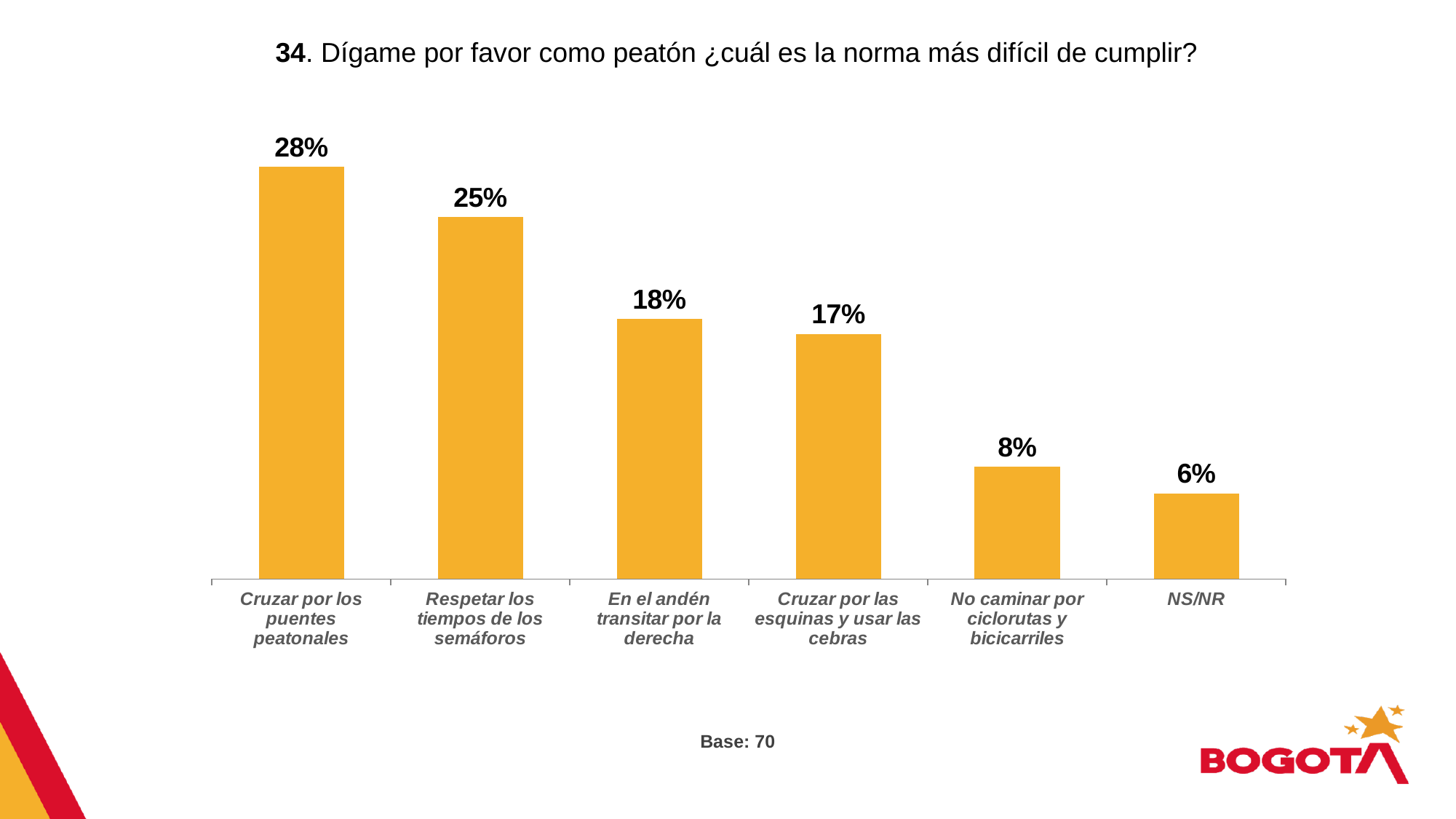
How many categories are shown in the chart? 6 What is the value for "Respetar los tiempos de los semáforos"? 25% Which category has the highest value? Cruzar por los puentes peatonales What is the difference between "Cruzar por las esquinas y usar las cebras" and "No caminar por ciclorutas y bicicarriles"? 9% What kind of chart is shown on the slide? Bar chart Which category has the lowest value? NS/NR What is the value for "NS/NR"? 6% Which is larger, the value for "En el andén transitar por la derecha" or for "No caminar por ciclorutas y bicicarriles"? En el andén transitar por la derecha What percentage is shown for "Cruzar por los puentes peatonales"? 28% What percentage is shown for "En el andén transitar por la derecha"? 18% What is the base (number of respondents) stated below the chart? 70 What is the difference between "Cruzar por los puentes peatonales" and "Respetar los tiempos de los semáforos"? 3%